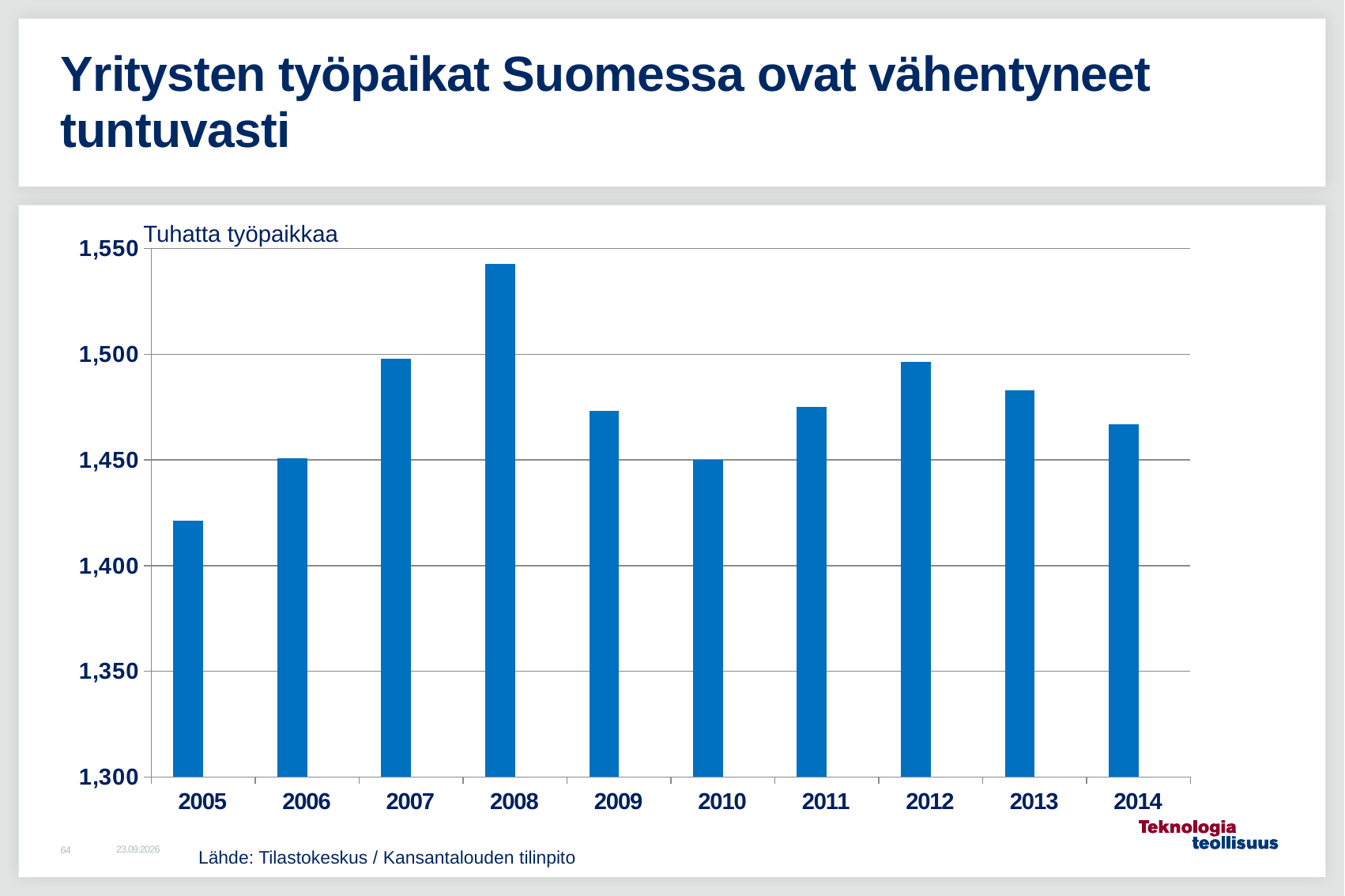
What unit label is shown above the y axis of the chart? Tuhatta työpaikkaa Which year has the lowest number of jobs in the chart? 2005 Do the values rise or fall from 2005 to 2008? rise Is the value for 2008 greater or less than 1,500? greater Is the value for 2005 greater or less than 1,400? greater Which year has the larger value, 2008 or 2009? 2008 Which year has the larger value, 2005 or 2014? 2014 What kind of chart is shown on the slide? bar chart How many years are shown on the x axis of the chart? 10 Is the value for 2014 greater or less than 1,450? greater Which year has the highest number of jobs in the chart? 2008